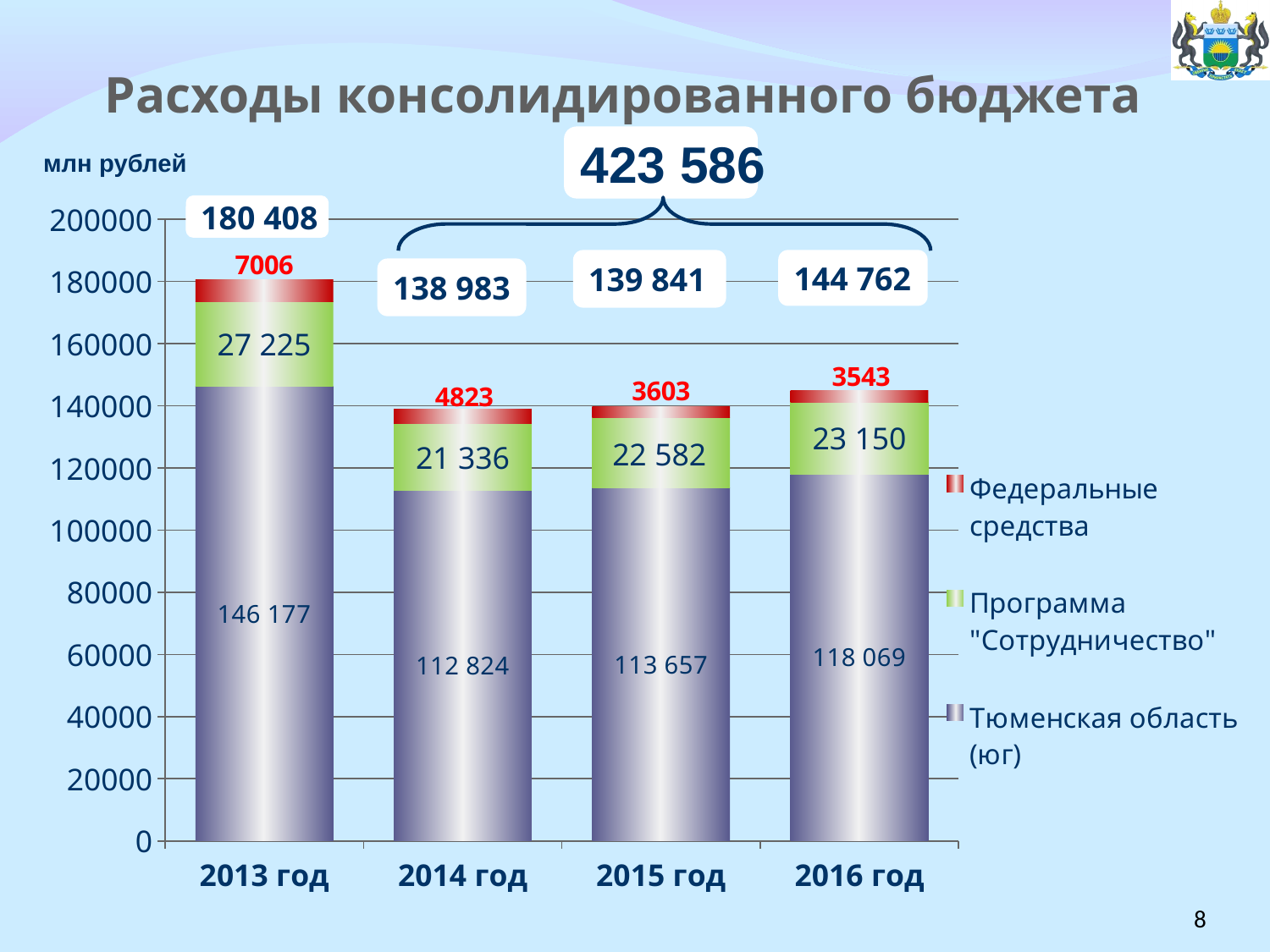
What is the total of the stacked bar for 2016 год? 144 762 Which year has the highest total consolidated budget expenditure? 2013 год How many series does the legend list? 3 What is the difference between the Тюменская область (юг) values for 2016 год and 2015 год? 4 412 What unit of measurement is indicated above the chart? млн рублей How many years are shown on the x axis? 4 Which year has the lowest value for Федеральные средства? 2016 год What is the value for Тюменская область (юг) in 2013 год? 146 177 What is the value for Программа "Сотрудничество" in 2015 год? 22 582 Which is larger: the Программа "Сотрудничество" value in 2014 год or in 2016 год? 2016 год What is the value for Федеральные средства in 2014 год? 4823 What kind of chart is shown on the slide? Stacked bar chart